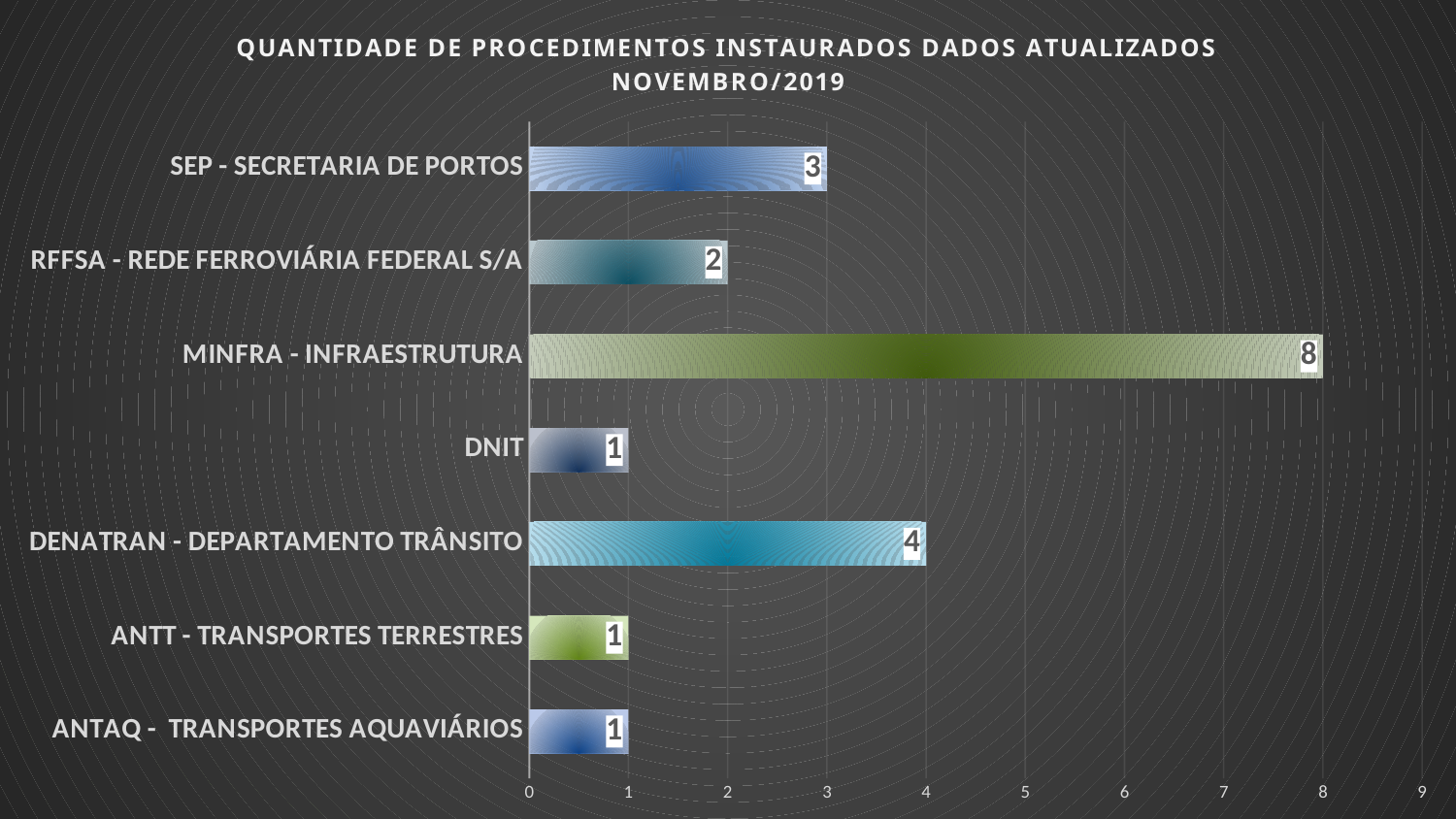
How many categories have a value of 1? 3 What is the value for MINFRA - INFRAESTRUTURA? 8 What is the difference between the values for DENATRAN - DEPARTAMENTO TRÂNSITO and DNIT? 3 What is the value for SEP - SECRETARIA DE PORTOS? 3 What is the title of the chart? QUANTIDADE DE PROCEDIMENTOS INSTAURADOS DADOS ATUALIZADOS NOVEMBRO/2019 What is the value for RFFSA - REDE FERROVIÁRIA FEDERAL S/A? 2 What kind of chart is this? Bar chart Which category has the highest value? MINFRA - INFRAESTRUTURA Which is larger, the value for SEP - SECRETARIA DE PORTOS or the value for RFFSA - REDE FERROVIÁRIA FEDERAL S/A? SEP - SECRETARIA DE PORTOS How many categories are shown in the chart? 7 What is the difference between the values for MINFRA - INFRAESTRUTURA and DENATRAN - DEPARTAMENTO TRÂNSITO? 4 What is the value for DENATRAN - DEPARTAMENTO TRÂNSITO? 4